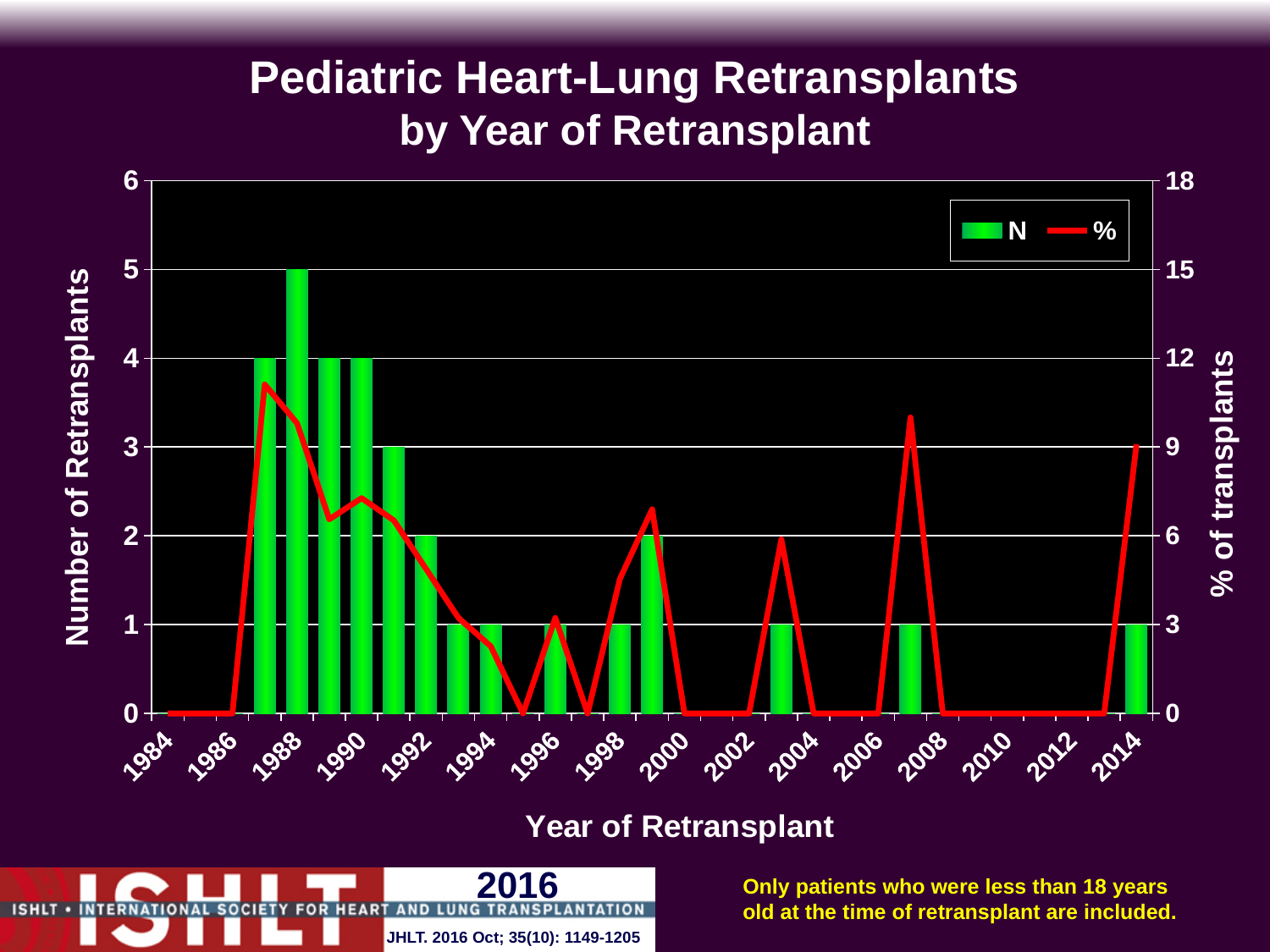
Which year has more retransplants, 1988 or 1992? 1988 What is the number of retransplants (N) in 1990? 4 How many series does the legend list? 2 What is the number of retransplants (N) in 2014? 1 What is the difference in the number of retransplants between 1988 and 1990? 1 What is the label of the right-hand vertical axis? % of transplants What is the number of retransplants (N) in 1992? 2 Is the % of transplants value in 2014 greater or less than 6? greater Do the number of retransplants bars rise or fall from 1988 to 1994? fall Which year has the highest number of retransplants (N)? 1988 Is the % of transplants value in 1988 greater or less than 6? greater What is the number of retransplants (N) in 1988? 5